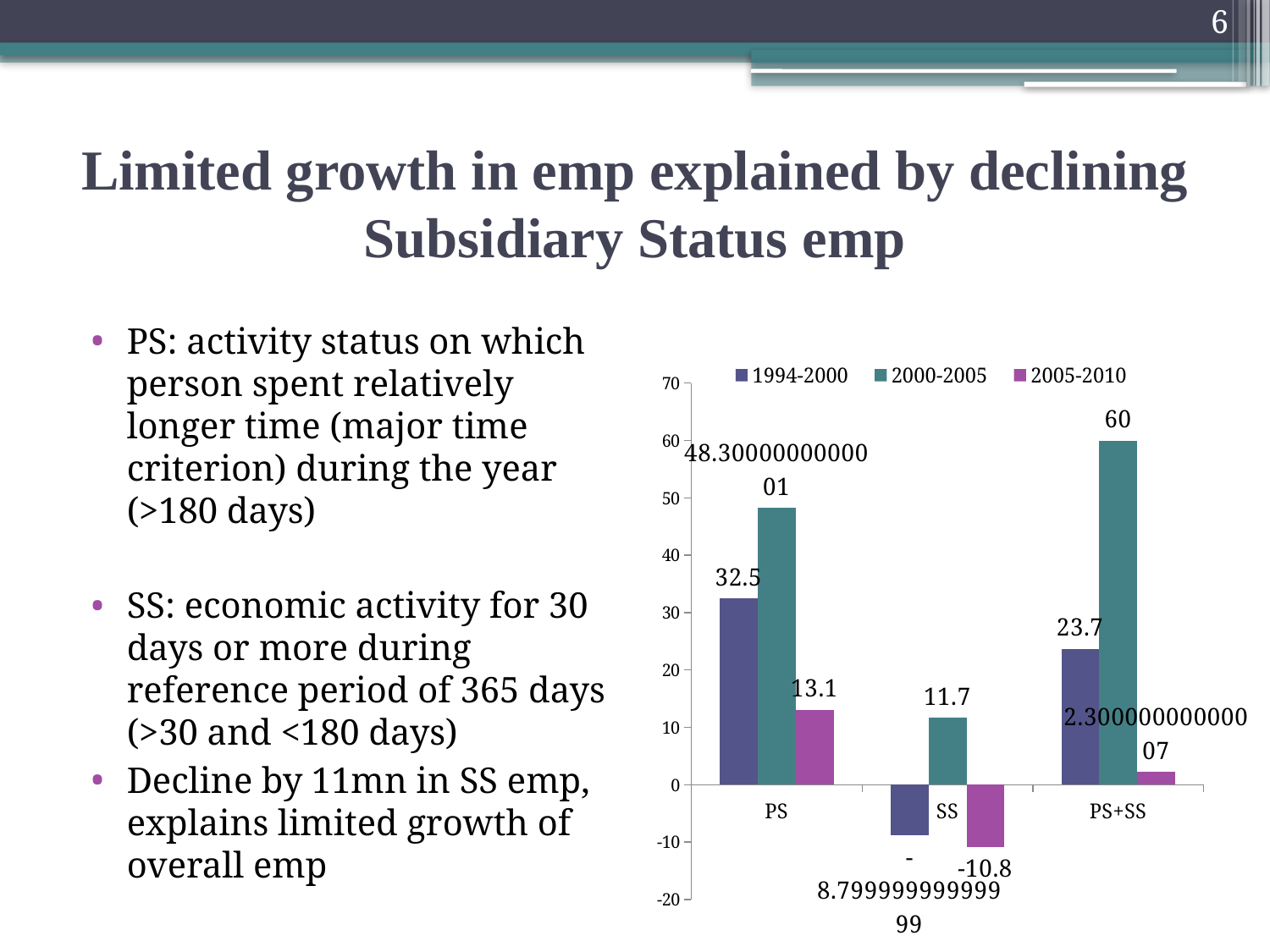
What is the value for 2005-2010 in the SS category? -10.8 What is the value for 2005-2010 in the PS category? 13.1 What type of chart is shown on the slide? bar chart What is the value for 1994-2000 in the PS category? 32.5 How many series does the chart legend list? 3 What is the value for 1994-2000 in the PS+SS category? 23.7 What is the difference between the 2000-2005 and 1994-2000 values in the PS+SS category? 36.3 What is the value for 2000-2005 in the SS category? 11.7 Is the value for 2000-2005 in the PS category greater or less than 40? greater How many categories are shown on the x axis of the chart? 3 What is the value for 2000-2005 in the PS+SS category? 60 Which series has the highest value in the PS+SS category? 2000-2005